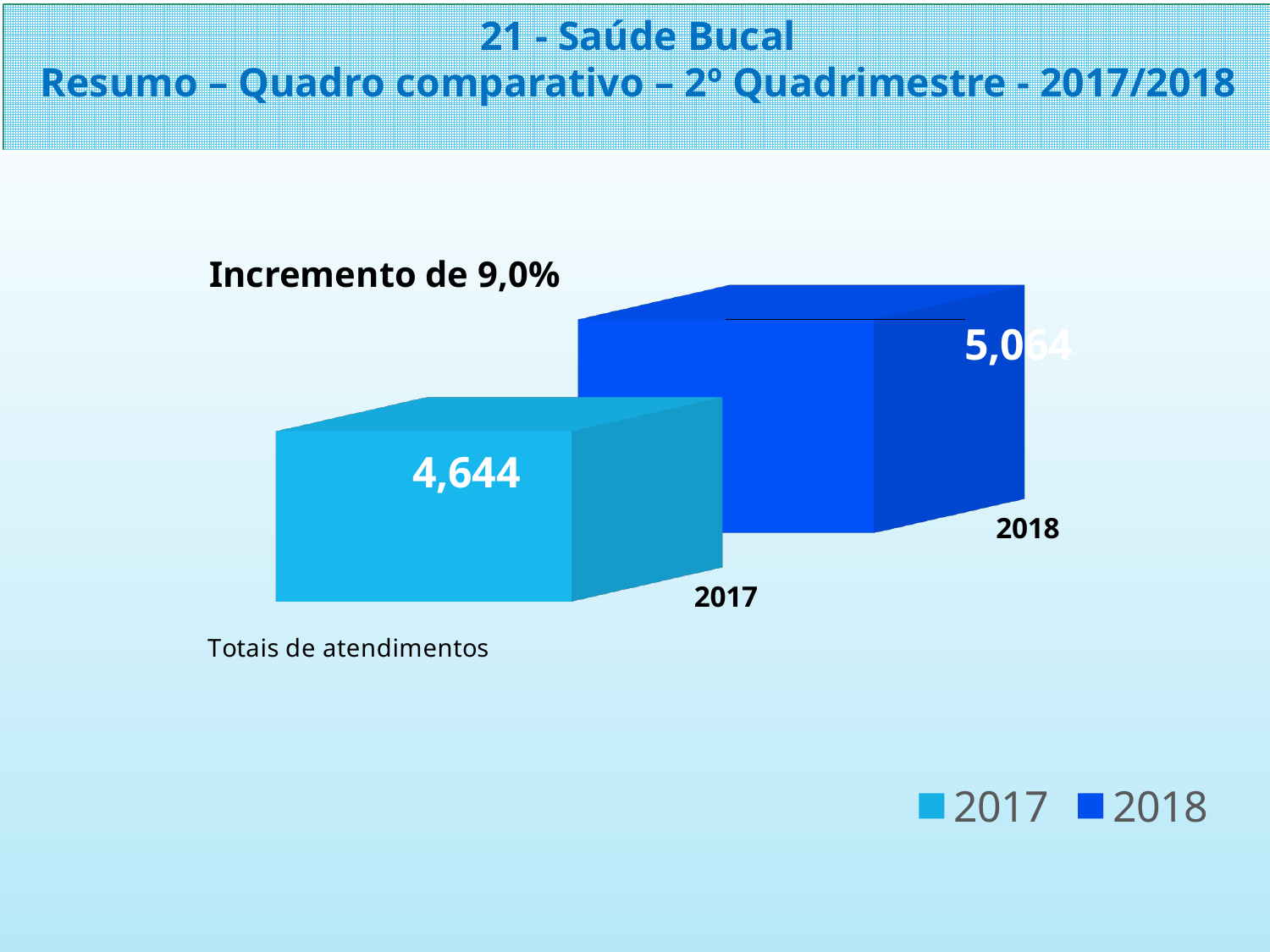
What is the value for 2018? 5,064 Which year has the higher value? 2018 How many entries does the legend list? 2 What is the label below the chart describing what the bars represent? Totais de atendimentos What kind of chart is shown on the slide? Bar chart What percentage increase is stated above the chart? 9,0% What is the difference between the 2018 and 2017 values? 420 How many bars are plotted in the chart? 2 Which year has the lower value? 2017 What is the value for 2017? 4,644 Is the value for 2018 larger than the value for 2017? Yes Do the values rise or fall from 2017 to 2018? Rise